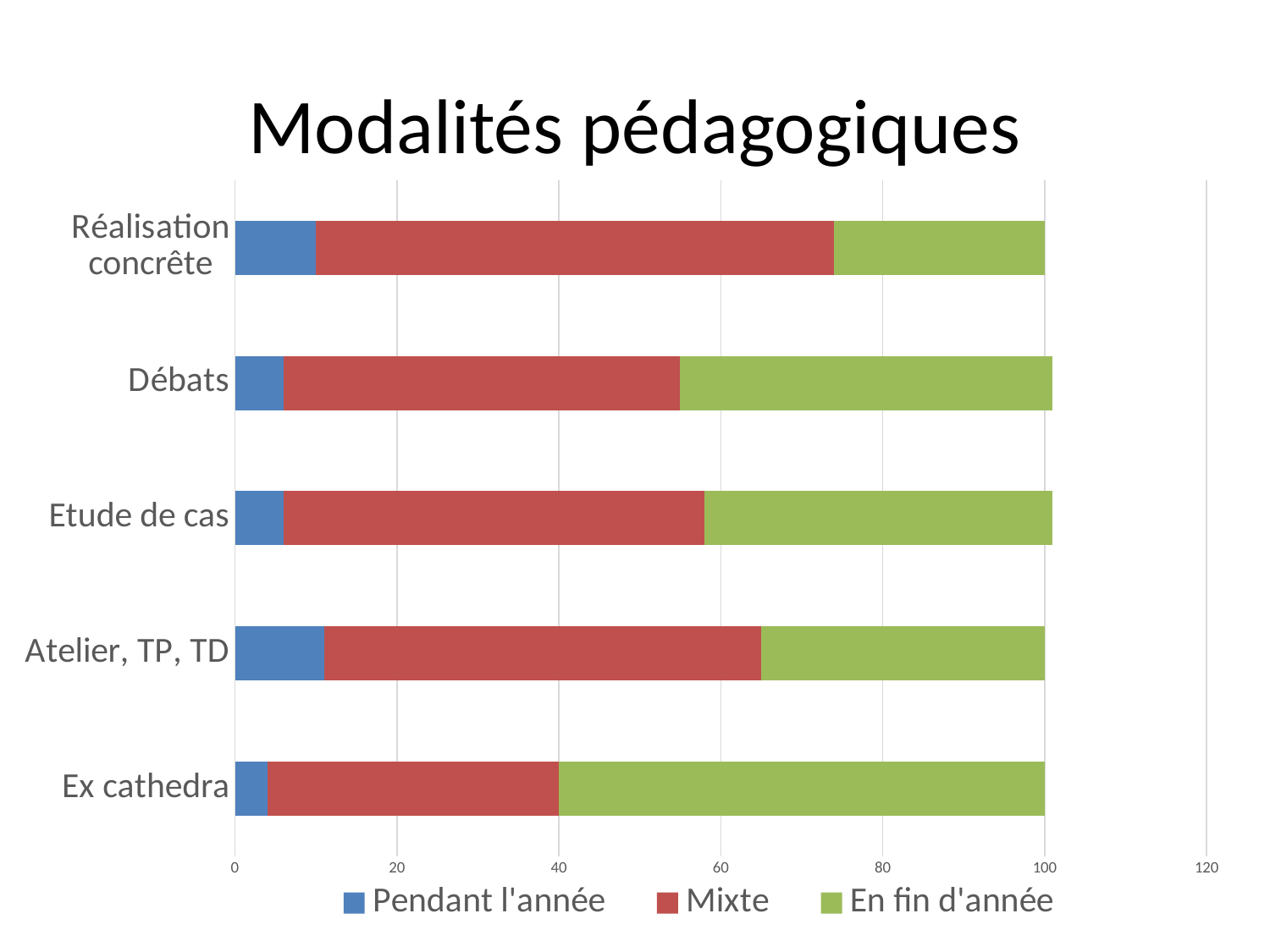
How many series does the legend list? 3 What is the title of the chart? Modalités pédagogiques Which category has the smallest Mixte segment? Ex cathedra Which series is shown in green in the legend? En fin d'année Which category has the largest En fin d'année segment? Ex cathedra How many categories are shown on the chart? 5 What kind of chart is shown on the slide? Stacked bar chart Which category has the smallest En fin d'année segment? Réalisation concrête Which is larger, the Mixte segment for Réalisation concrête or the Mixte segment for Ex cathedra? Réalisation concrête Is the Pendant l'année segment for Réalisation concrête greater or less than 20? less Is the Mixte segment for Ex cathedra greater or less than 20? greater Which category has the largest Mixte segment? Réalisation concrête